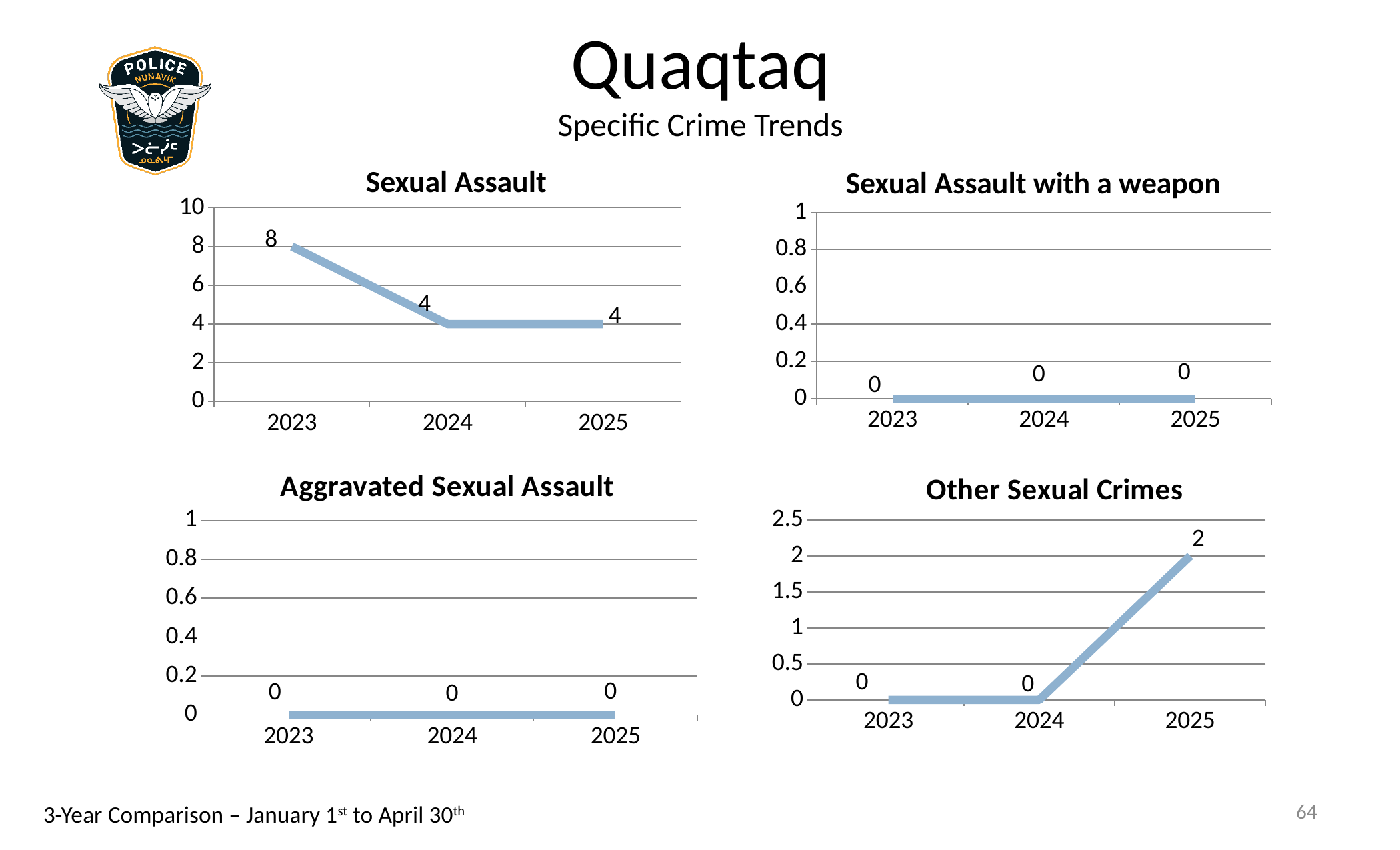
In the Other Sexual Crimes chart, which year has the highest value? 2025 In the Sexual Assault chart, what is the difference between the 2023 and 2024 values? 4 How many years are plotted in the Sexual Assault chart? 3 In the Sexual Assault chart, which year has the highest value? 2023 In the Sexual Assault chart, do the values rise or fall from 2023 to 2024? fall In the Aggravated Sexual Assault chart, what is the value for 2025? 0 In the Sexual Assault with a weapon chart, what is the value for 2024? 0 In the Sexual Assault chart, what is the value for 2023? 8 In the Other Sexual Crimes chart, what is the value for 2025? 2 In the Sexual Assault chart, what is the value for 2025? 4 What kind of chart is the Other Sexual Crimes chart? line chart In the Other Sexual Crimes chart, is the value for 2025 greater or less than 1? greater